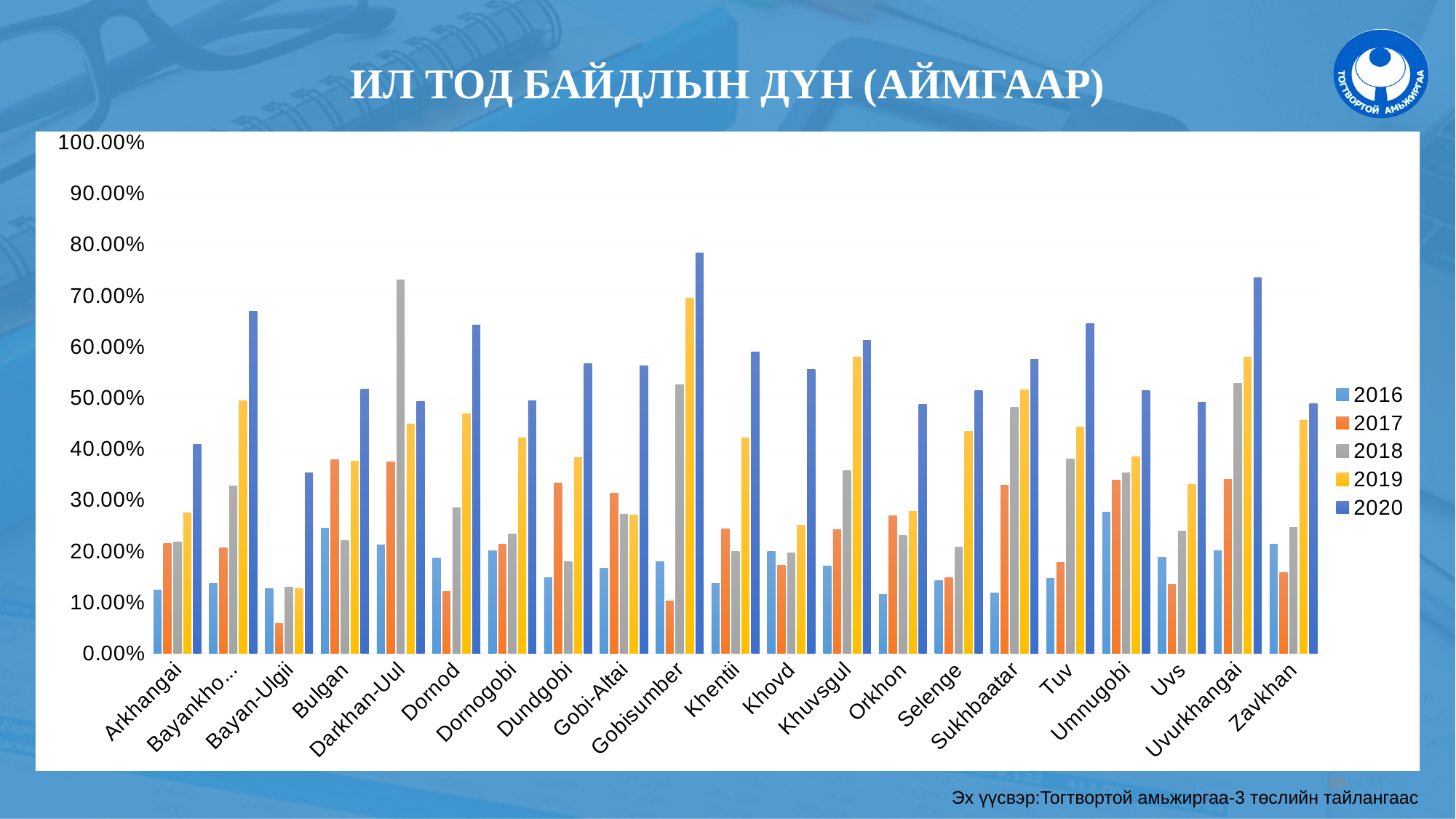
What kind of chart is shown on the slide? bar chart How many provinces (categories) are shown along the x axis? 21 Which is larger: the 2020 value for Gobisumber or the 2020 value for Zavkhan? Gobisumber Is the 2017 value for Bayan-Ulgii greater or less than 10.00%? less For Khuvsgul, do the values rise or fall from 2016 to 2020? rise Is the 2020 value for Gobisumber greater or less than 70.00%? greater For Darkhan-Uul, which is larger: the 2018 value or the 2019 value? 2018 Which colour represents the 2019 series in the legend? yellow How many series does the legend list? 5 Is the 2019 value for Khuvsgul greater or less than 50.00%? greater Which province has the highest value for 2020? Gobisumber Which province has the lowest value for 2020? Bayan-Ulgii